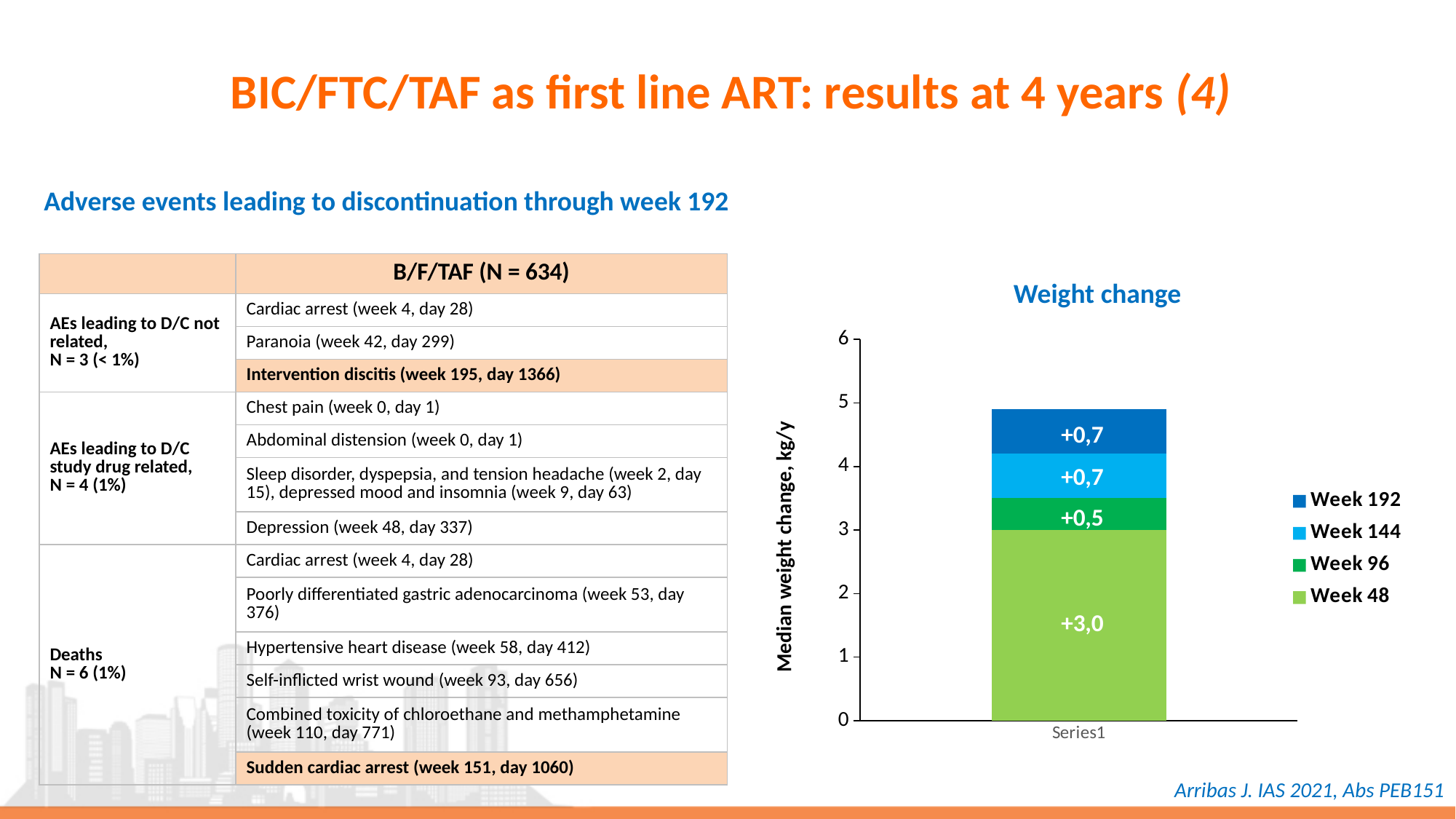
In the Weight change chart, is the top of the stacked bar greater or less than 4? greater In the Weight change chart, what is the total of the stacked bar? 4,9 In the Weight change chart, which is larger, the Week 48 value or the Week 144 value? Week 48 What is the y-axis label of the Weight change chart? Median weight change, kg/y In the Weight change chart, what is the difference between the Week 48 value and the Week 96 value? 2,5 What kind of chart is the Weight change chart? Stacked bar chart How many series does the legend of the Weight change chart list? 4 In the Weight change chart, which series has the smallest segment in the stacked bar? Week 96 In the Weight change chart, what is the value labelled for Week 48? +3,0 In the Weight change chart, what is the value labelled for Week 96? +0,5 In the Weight change chart, which series has the largest segment in the stacked bar? Week 48 In the Weight change chart, what is the value labelled for Week 192? +0,7